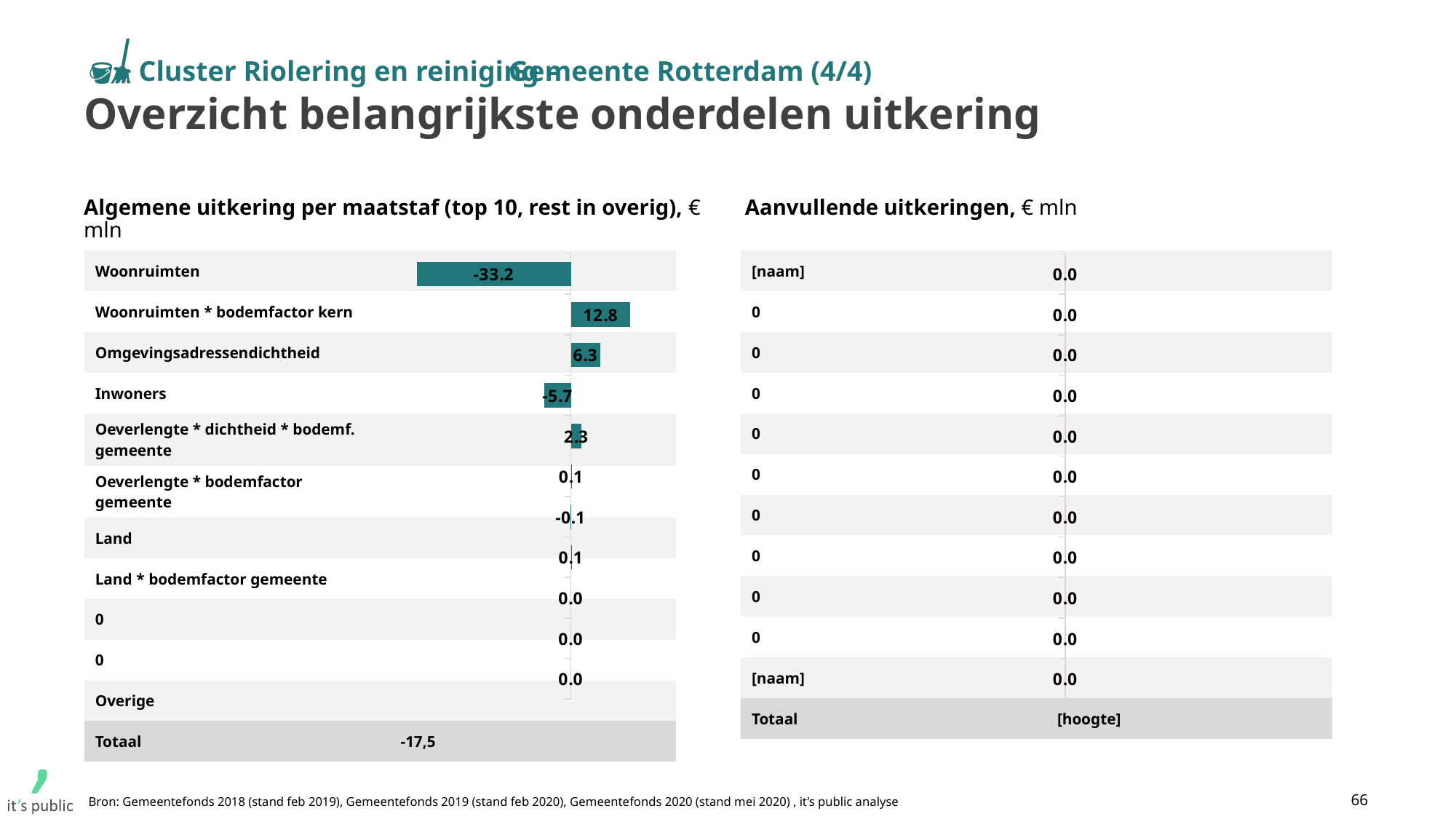
How many categories are shown in the chart 'Algemene uitkering per maatstaf' (excluding the Totaal row)? 11 In the chart 'Algemene uitkering per maatstaf', which category has the highest value? Woonruimten * bodemfactor kern In the chart 'Algemene uitkering per maatstaf', what is the value for Inwoners? -5.7 In the chart 'Algemene uitkering per maatstaf', which is larger: the value for Omgevingsadressendichtheid or the value for Oeverlengte * dichtheid * bodemf. gemeente? Omgevingsadressendichtheid In the chart 'Algemene uitkering per maatstaf', what is the value for Woonruimten? -33.2 What unit is stated in the title of the chart 'Aanvullende uitkeringen'? € mln What is the Totaal shown below the chart 'Algemene uitkering per maatstaf'? -17,5 What kind of chart is 'Algemene uitkering per maatstaf'? Bar chart In the chart 'Algemene uitkering per maatstaf', which category has the lowest value? Woonruimten In the chart 'Algemene uitkering per maatstaf', what is the value for Woonruimten * bodemfactor kern? 12.8 In the chart 'Algemene uitkering per maatstaf', what is the difference between the values for Woonruimten * bodemfactor kern and Omgevingsadressendichtheid? 6.5 In the chart 'Algemene uitkering per maatstaf', what is the value for Omgevingsadressendichtheid? 6.3